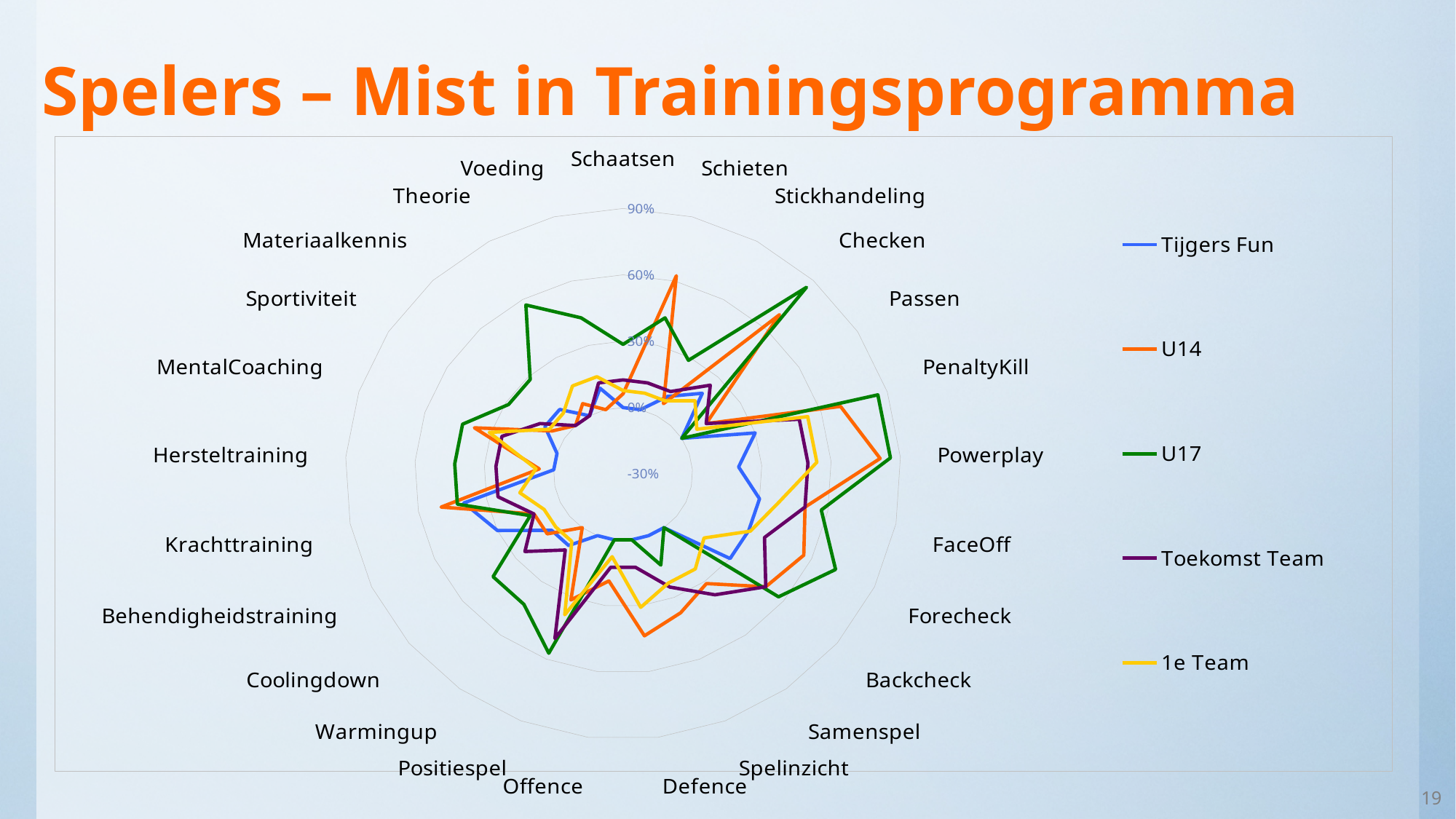
Which series is drawn in orange in the legend? U14 How many series does the legend list? 5 Is the value for U17 at Checken greater or less than 60%? greater How many categories are plotted around the radar chart? 25 Is the value for U17 at Powerplay greater or less than 60%? greater Which series has the highest value at Checken? U17 Is the value for Tijgers Fun at Powerplay greater or less than 60%? less What kind of chart is shown on the slide? Radar chart Which series is drawn in green in the legend? U17